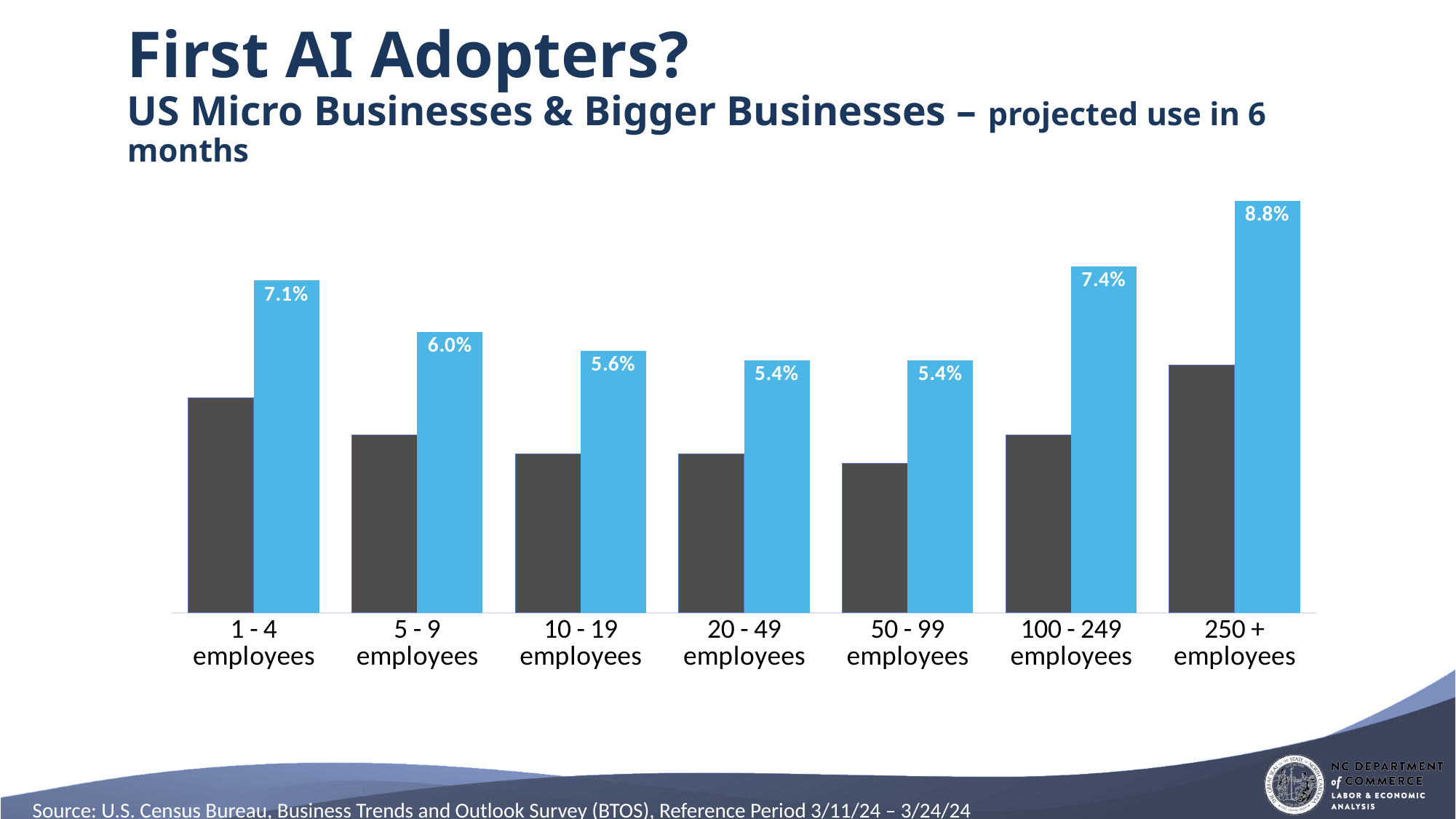
What is the value of the light blue bar for 10 - 19 employees? 5.6% What is the value of the light blue bar for 5 - 9 employees? 6.0% What is the value of the light blue bar for 100 - 249 employees? 7.4% How many employee-size categories are shown on the x axis? 7 What type of chart is shown on the slide? bar chart What is the value of the light blue bar for 250 + employees? 8.8% Which employee-size category has the highest light blue bar? 250 + employees What is the value of the light blue bar for 1 - 4 employees? 7.1% Do the light blue bar values rise or fall from 1 - 4 employees to 20 - 49 employees? fall Which has a larger light blue bar value: 5 - 9 employees or 100 - 249 employees? 100 - 249 employees What is the difference between the light blue bar values for 250 + employees and 1 - 4 employees? 1.7% What is the lowest value labelled on the light blue bars? 5.4%